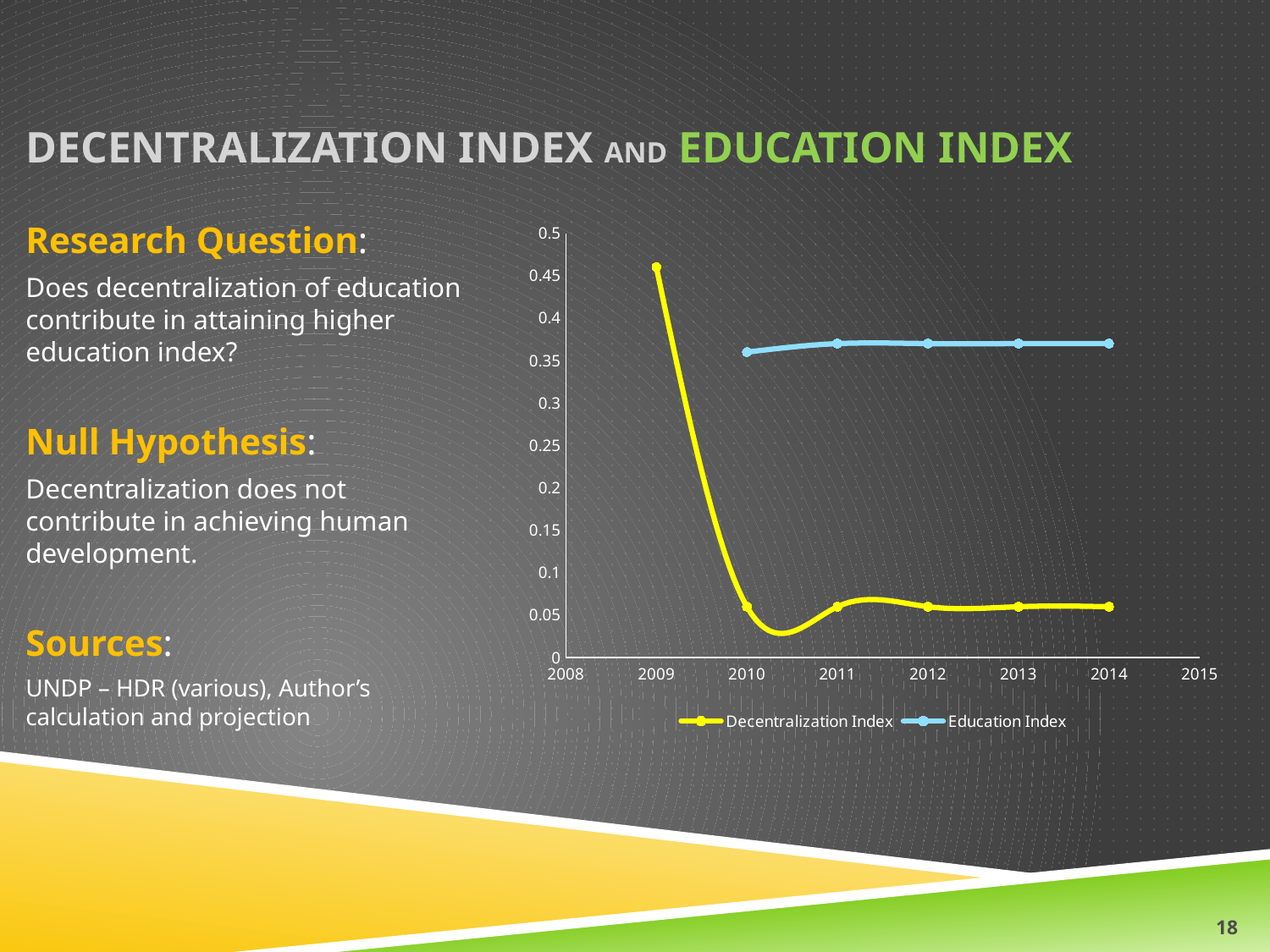
Which series is drawn in blue? Education Index Does the Decentralization Index rise or fall between 2009 and 2010? fall What kind of chart is shown on the slide? Line chart In 2012, which series has the larger value, Decentralization Index or Education Index? Education Index How many series does the chart legend list? 2 Is the Education Index value for 2010 greater or less than 0.4? less Is the Education Index value for 2012 greater or less than 0.3? greater Is the Decentralization Index value for 2009 greater or less than 0.4? greater Which series is drawn in yellow? Decentralization Index How many data points are plotted for the Education Index series? 5 Which year has the highest Decentralization Index value? 2009